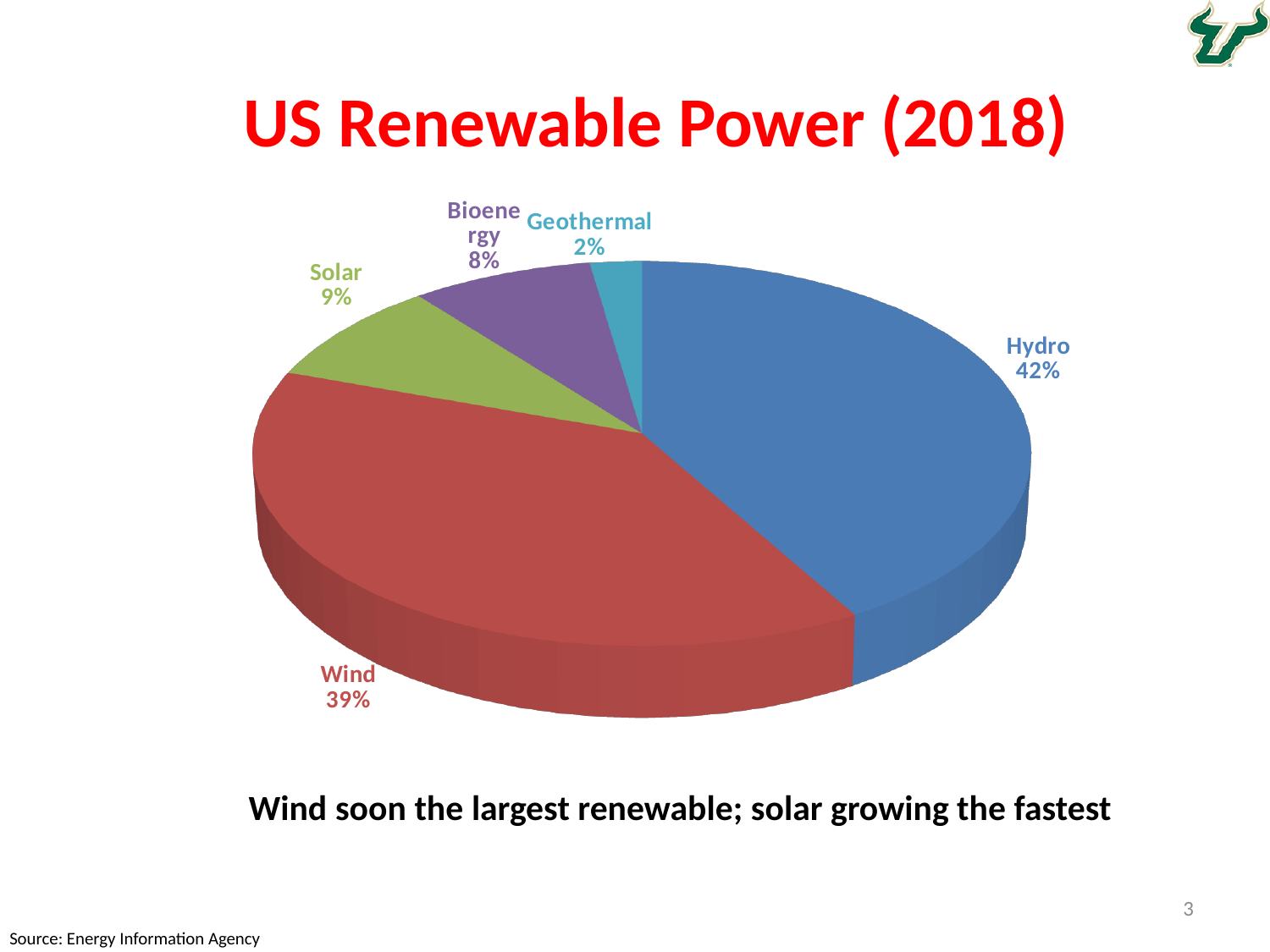
What is the difference in percentage points between Hydro and Wind? 3 Which renewable source has the largest share of the pie? Hydro What percentage is shown for Solar? 9% What is the difference in percentage points between Solar and Geothermal? 7 Which renewable source has the smallest share of the pie? Geothermal What percentage is shown for Bioenergy? 8% How many categories are shown in the pie chart? 5 What percentage is shown for Geothermal? 2% What share of the pie does Wind represent? 39% What share of US renewable power in 2018 does Hydro account for? 42% Which is larger, the share for Solar or the share for Bioenergy? Solar What kind of chart is shown on the slide? Pie chart